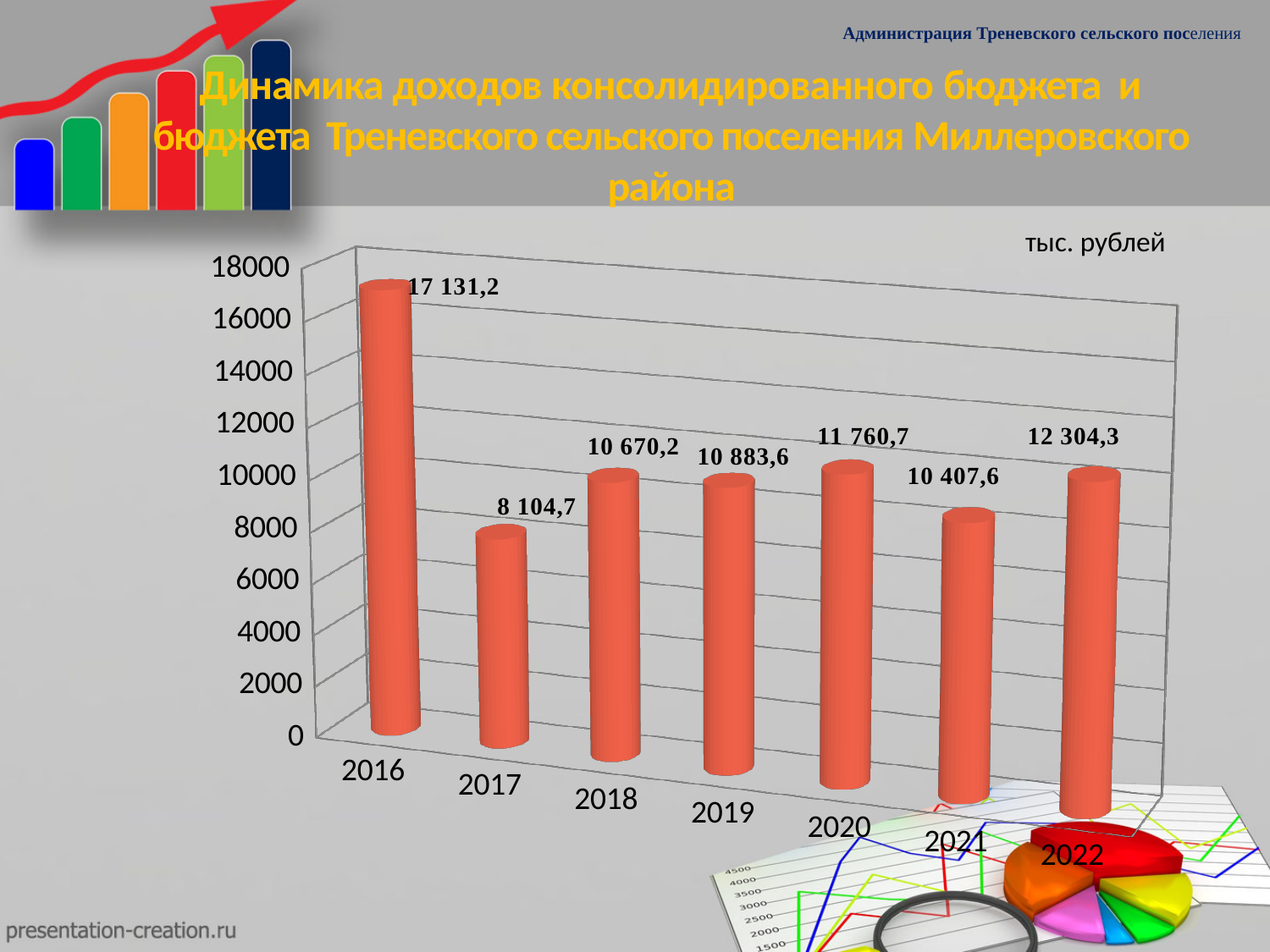
What is the value for 2022? 12 304,3 How many years are shown on the x axis? 7 Which year has the lowest value? 2017 What is the value for 2017? 8 104,7 What kind of chart is shown on the slide? bar chart Is the value for 2018 greater or less than 10000? greater Which year has the highest value? 2016 Which is larger, the value for 2019 or the value for 2021? 2019 What is the value for 2020? 11 760,7 What is the difference between the values for 2022 and 2021? 1 896,7 What is the difference between the values for 2016 and 2017? 9 026,5 What is the value for 2016? 17 131,2